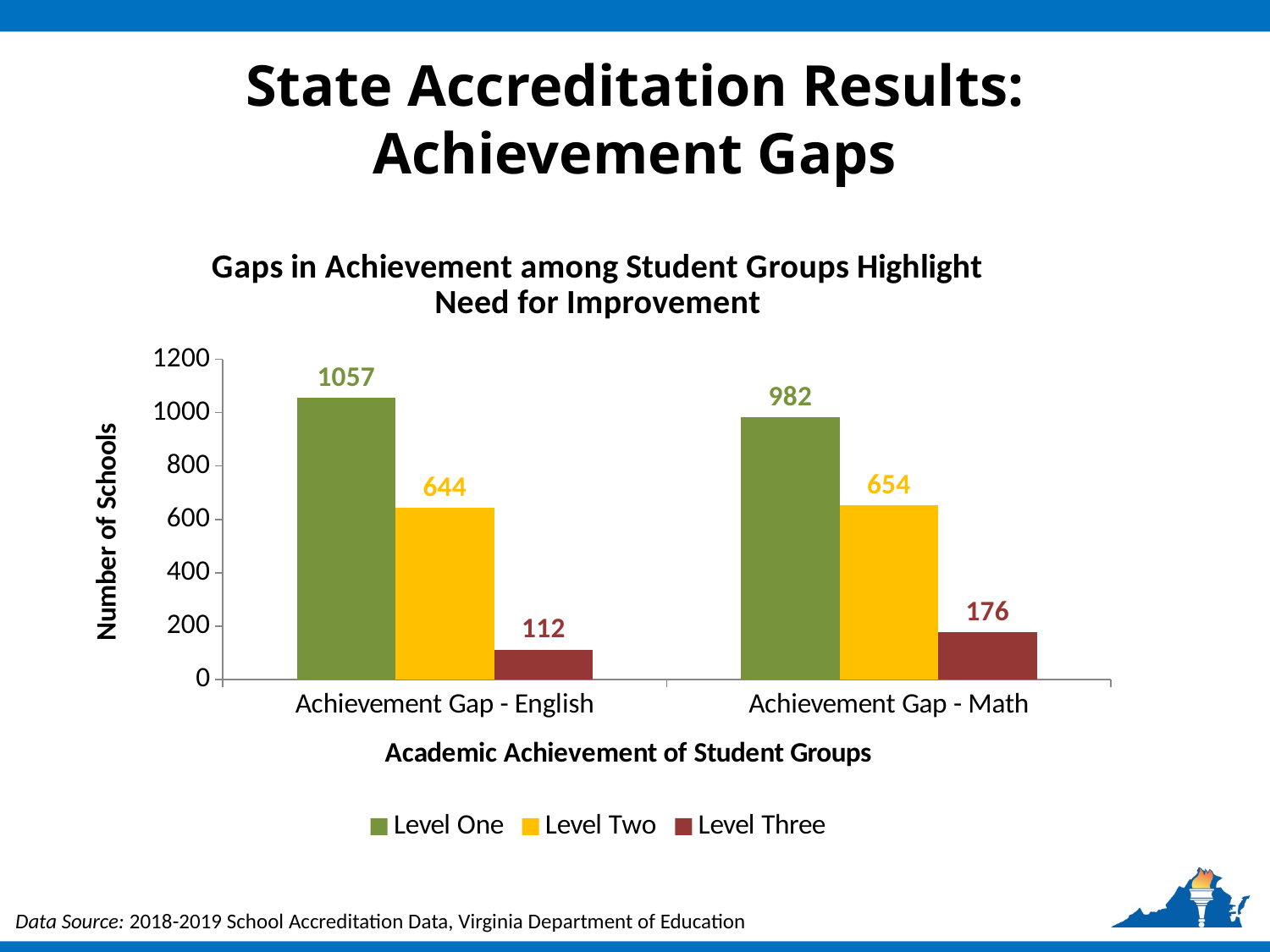
Which is larger: the Level Two value for Achievement Gap - English or for Achievement Gap - Math? Achievement Gap - Math Is the Level Two value for Achievement Gap - English greater or less than 600? greater What is the Level One value for Achievement Gap - English? 1057 What is the Level Three value for Achievement Gap - Math? 176 How many categories are shown on the x axis? 2 What is the difference between the Level Three values for Achievement Gap - Math and Achievement Gap - English? 64 Which category has the higher Level One value? Achievement Gap - English How many series does the legend list? 3 What is the difference between the Level One values for Achievement Gap - English and Achievement Gap - Math? 75 What is the Level Two value for Achievement Gap - Math? 654 Which series has the lowest value for Achievement Gap - English? Level Three What kind of chart is shown on the slide? Bar chart